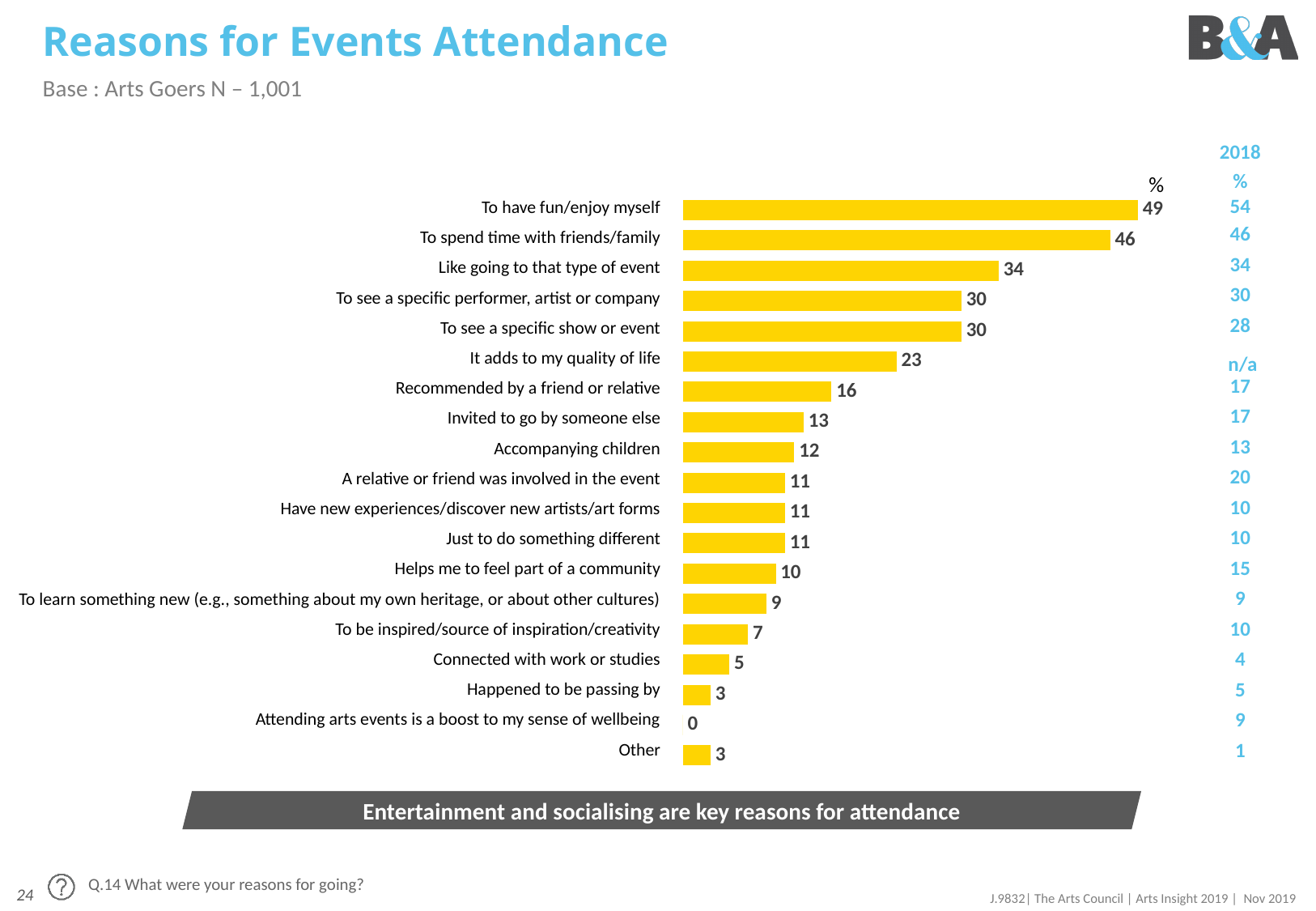
Which reason has the highest value in the chart? To have fun/enjoy myself What is the difference between the values for "Like going to that type of event" and "Recommended by a friend or relative"? 18 What is the difference between the values for "To have fun/enjoy myself" and "To spend time with friends/family"? 3 Which reason has the lowest value in the chart? Attending arts events is a boost to my sense of wellbeing How many reasons (categories) are plotted in the chart? 19 What is the value for "Accompanying children"? 12 What is the value for "It adds to my quality of life"? 23 Which is larger: the value for "Invited to go by someone else" or the value for "Helps me to feel part of a community"? Invited to go by someone else What colour are the bars in the chart? Yellow What type of chart is shown on the slide? Bar chart What is the value for "To have fun/enjoy myself"? 49 What is the value for "Attending arts events is a boost to my sense of wellbeing"? 0